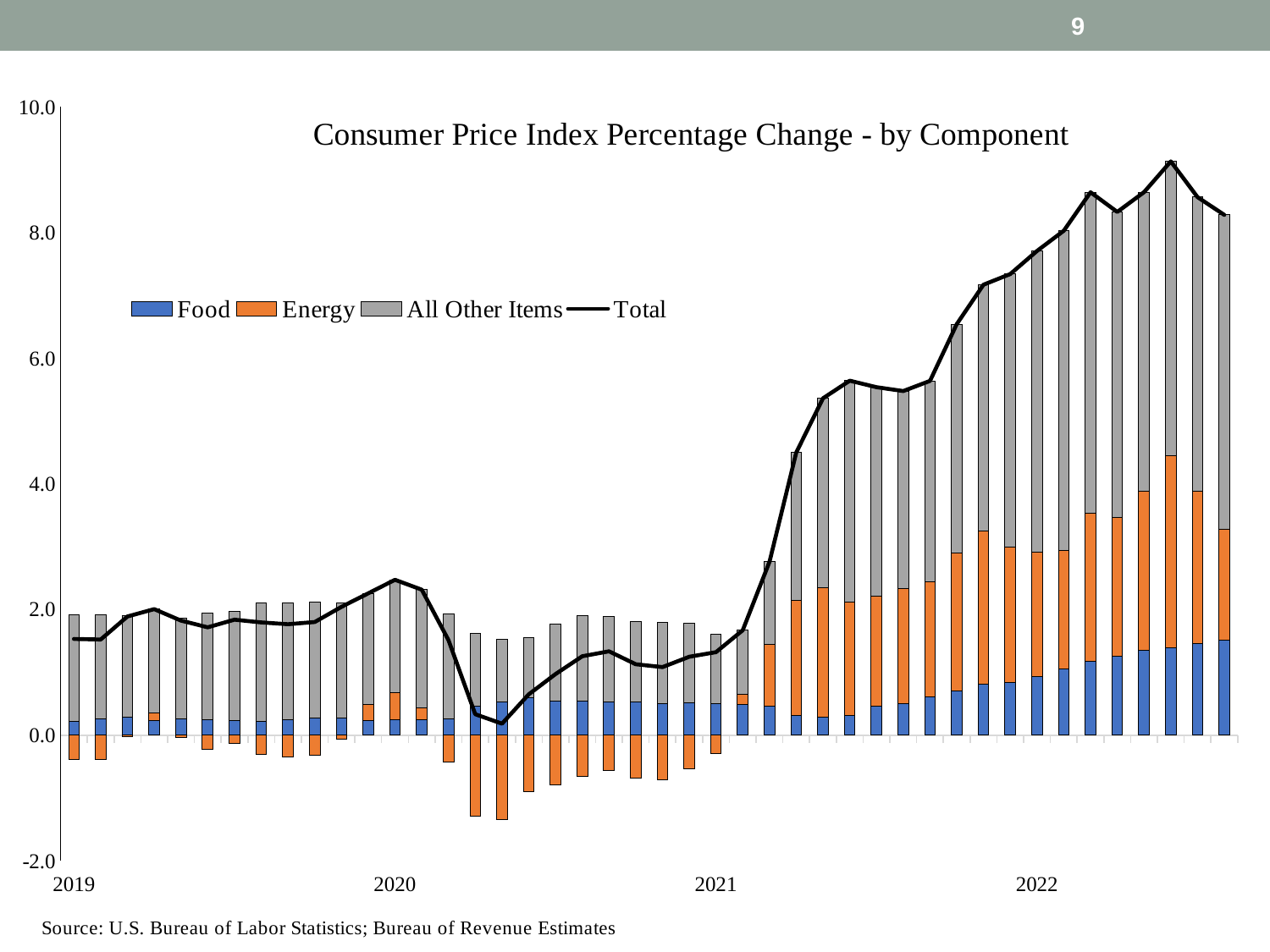
What is the title of the chart? Consumer Price Index Percentage Change - by Component Does the Total line rise or fall from the start of 2021 to the start of 2022? rise In which year labelled on the x axis does the Total line reach its highest point? 2022 Which is larger, the Total value at the start of 2019 or the Total value at the start of 2022? 2022 Is the lowest Energy value on the chart greater or less than 0.0? less Is the highest Total value on the chart greater or less than 8.0? greater What kind of chart is shown on the slide? Stacked bar chart with a line How many series does the legend list? 4 In which year labelled on the x axis does the Total line reach its lowest point? 2020 Is the lowest Total value on the chart greater or less than 2.0? less Which series is drawn as a line rather than bars? Total